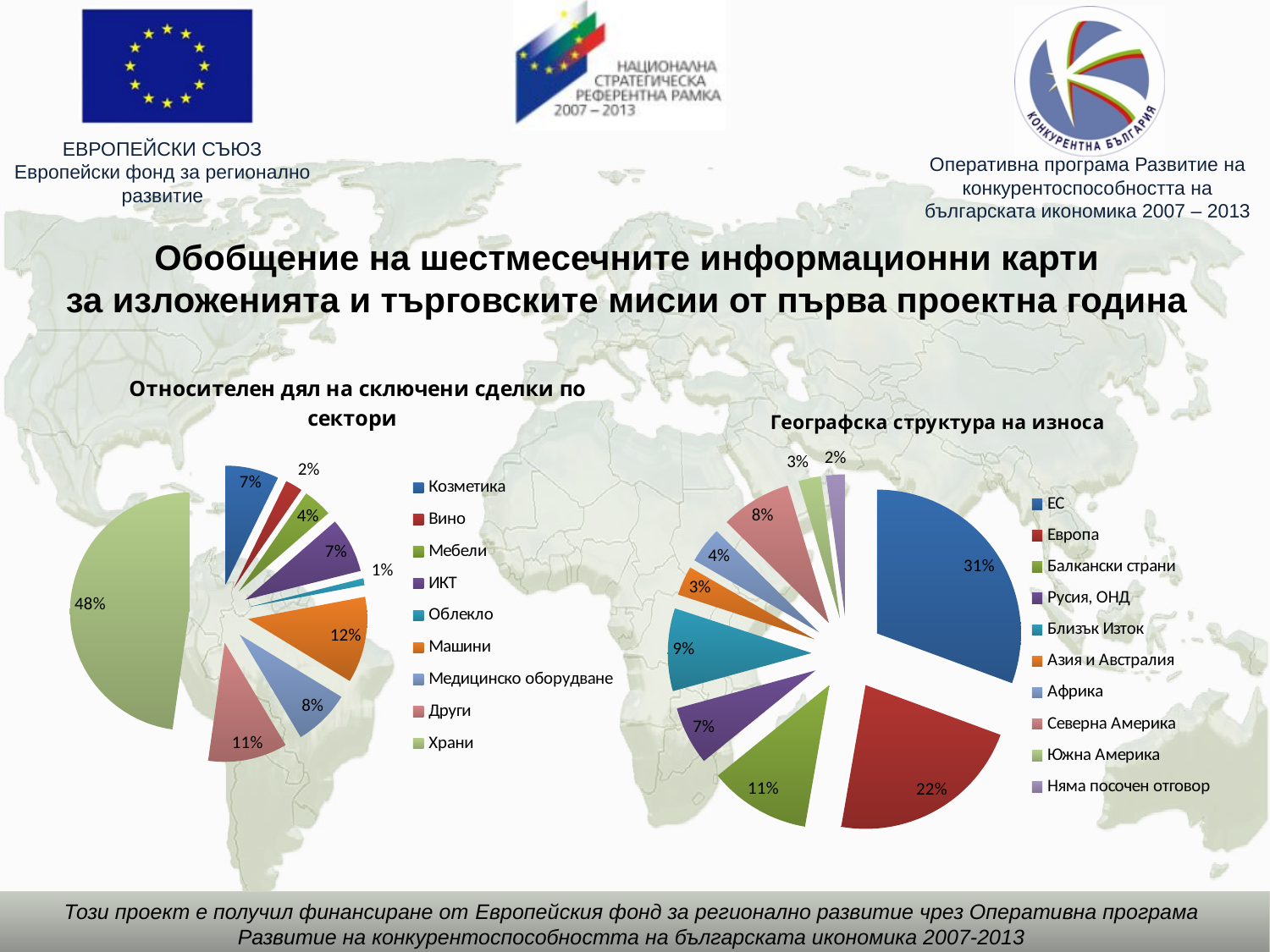
In the chart 'Географска структура на износа', what share does ЕС have? 31% In the chart 'Относителен дял на сключени сделки по сектори', which sector has the smallest share? Облекло In the chart 'Относителен дял на сключени сделки по сектори', what share does Машини have? 12% What type of chart is 'Географска структура на износа'? Pie chart In the chart 'Относителен дял на сключени сделки по сектори', what share does Храни have? 48% In the chart 'Географска структура на износа', how many categories does the legend list? 10 In the chart 'Относителен дял на сключени сделки по сектори', what is the difference between the shares of Други and Медицинско оборудване? 3% In the chart 'Географска структура на износа', which category has the largest share? ЕС In the chart 'Относителен дял на сключени сделки по сектори', how many sectors does the legend list? 9 In the chart 'Географска структура на износа', what share does Близък Изток have? 9% In the chart 'Относителен дял на сключени сделки по сектори', which sector has the largest share? Храни In the chart 'Географска структура на износа', which is larger: Балкански страни or Северна Америка? Балкански страни